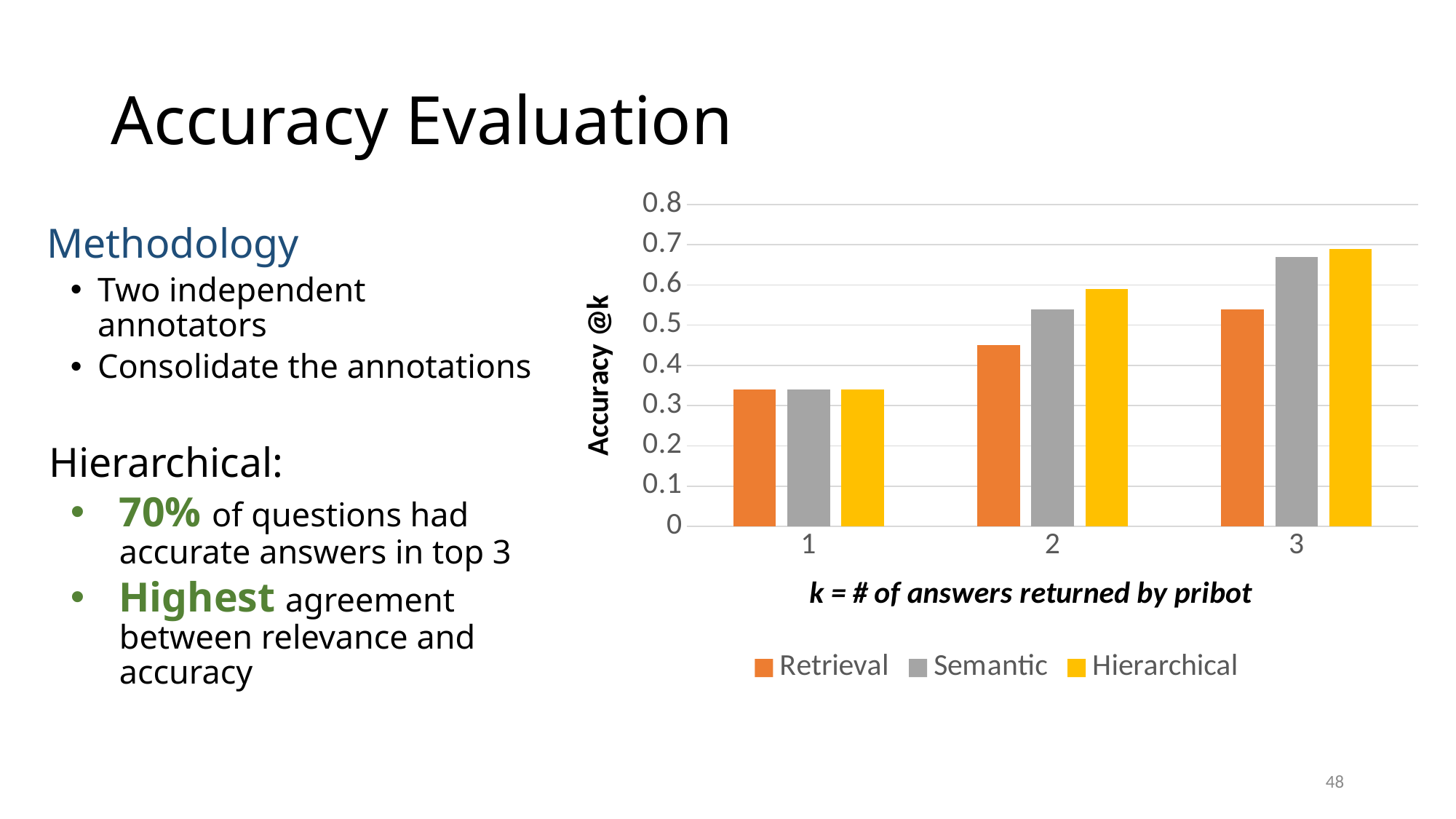
Is the Retrieval value at k = 1 greater or less than 0.4? less Which series has the lowest value at k = 3? Retrieval Is the Semantic value at k = 3 greater or less than 0.6? greater At k = 2, which is larger: the Retrieval value or the Semantic value? Semantic At k = 3, which is larger: the Retrieval value or the Hierarchical value? Hierarchical Does the Hierarchical accuracy rise or fall as k increases from 1 to 3? rise How many values of k are shown on the x axis of the chart? 3 What is the label on the vertical axis of the chart? Accuracy @k How many series does the chart legend list? 3 Is the Hierarchical value at k = 3 greater or less than 0.6? greater What kind of chart is shown on the slide? bar chart